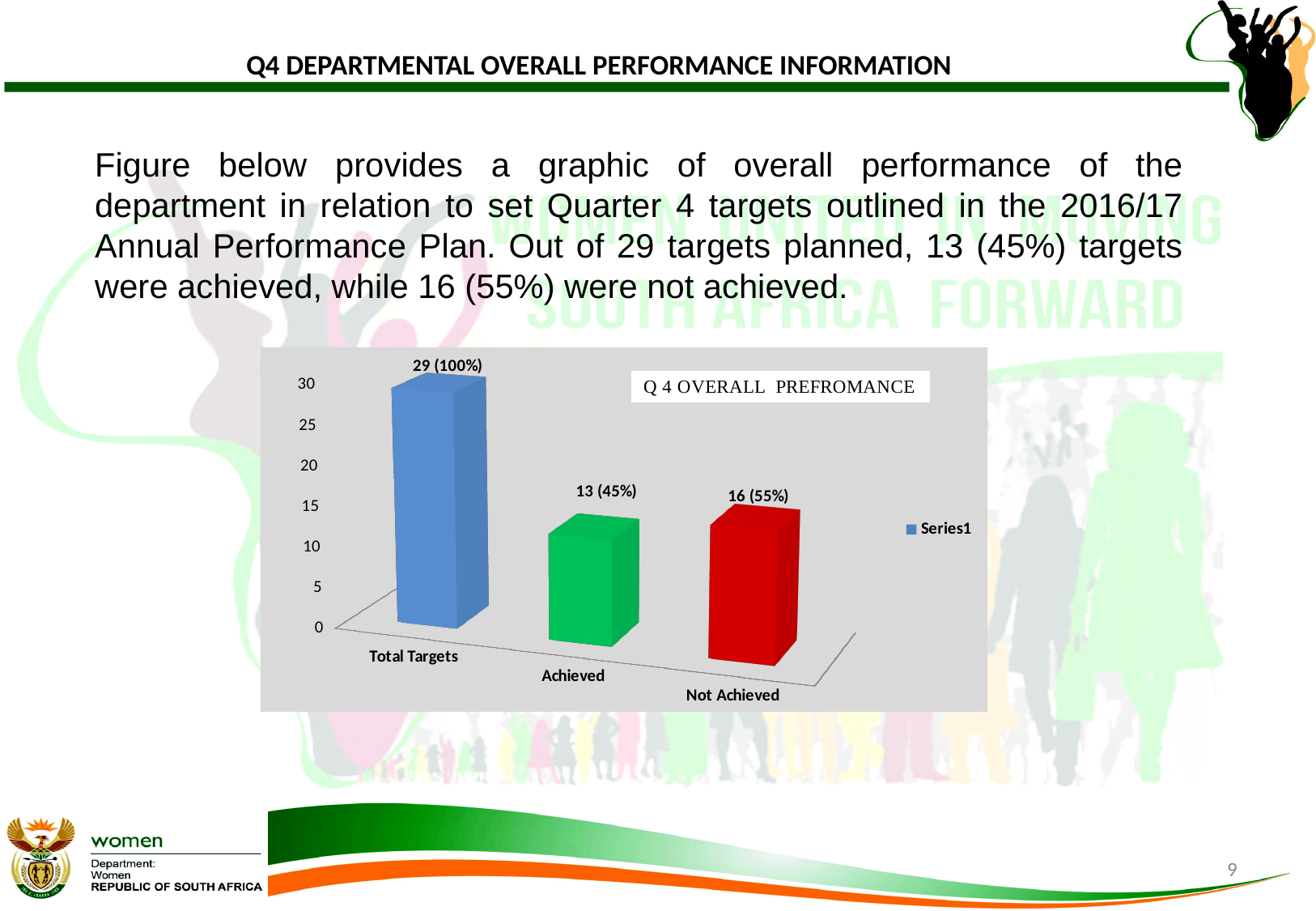
Which is larger, the value for Achieved or the value for Not Achieved? Not Achieved What is the data label on the Achieved bar? 13 (45%) Which category has the lowest value? Achieved How many categories are shown on the x axis? 3 Which category has the highest value? Total Targets What is the difference between the Not Achieved and Achieved values? 3 What is the data label on the Total Targets bar? 29 (100%) Is the value for Total Targets greater or less than 25? greater What kind of chart is shown on the slide? bar chart What is the title shown inside the chart? Q 4 OVERALL PREFROMANCE What is the data label on the Not Achieved bar? 16 (55%) What is the difference between the Total Targets and Achieved values? 16